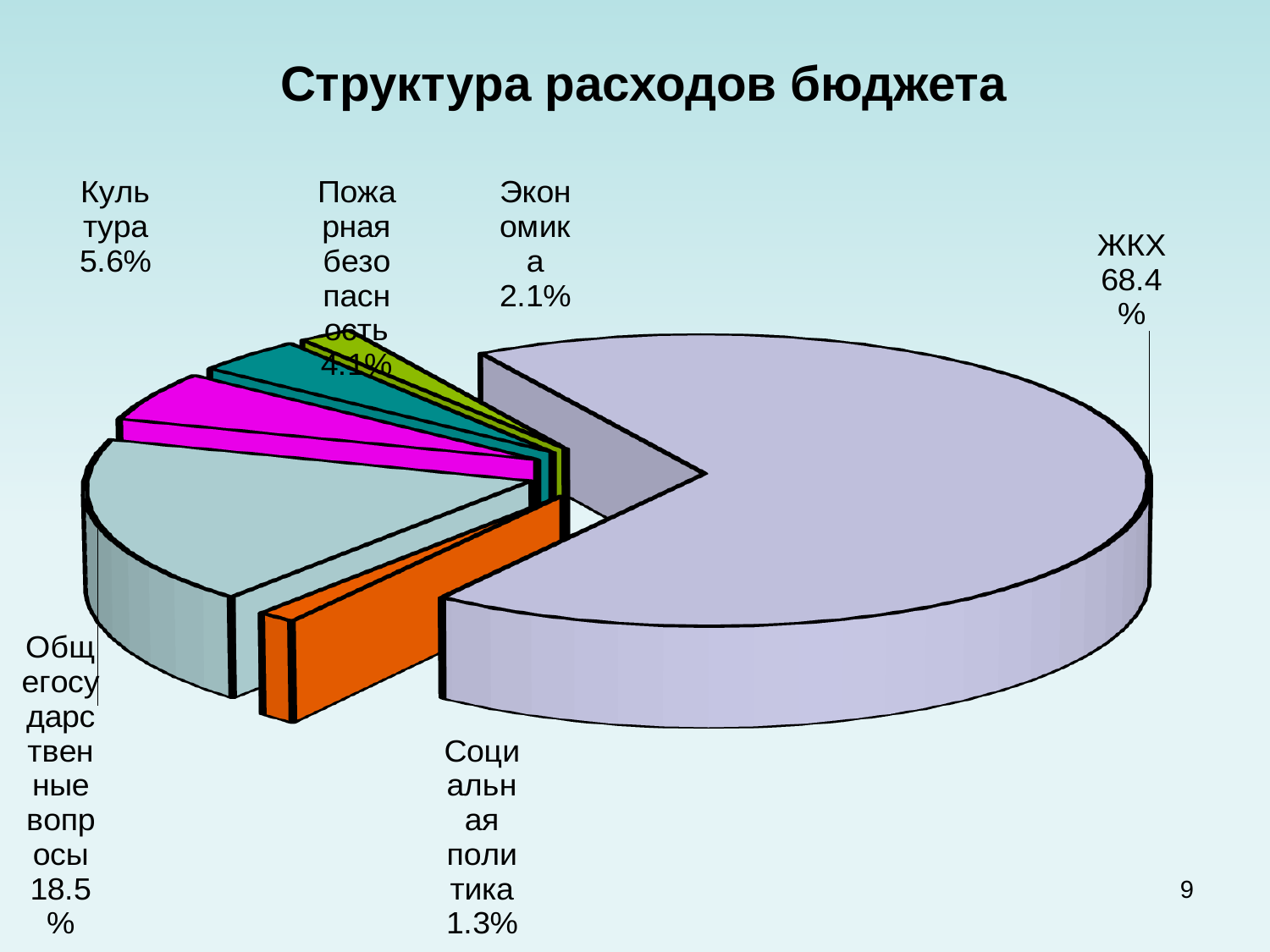
What is the difference between the shares for ЖКХ and Общегосударственные вопросы? 49.9% How many slices does the pie chart have? 6 Which category has the largest share of the pie? ЖКХ What share of budget expenditure goes to ЖКХ? 68.4% What is the value for Культура? 5.6% What is the title of the chart? Структура расходов бюджета What is the value for Общегосударственные вопросы? 18.5% What is the value for Социальная политика? 1.3% What is the value for Пожарная безопасность? 4.1% Which is larger, the share for Культура or the share for Экономика? Культура What kind of chart is shown on the slide? pie chart Which category has the smallest share of the pie? Социальная политика